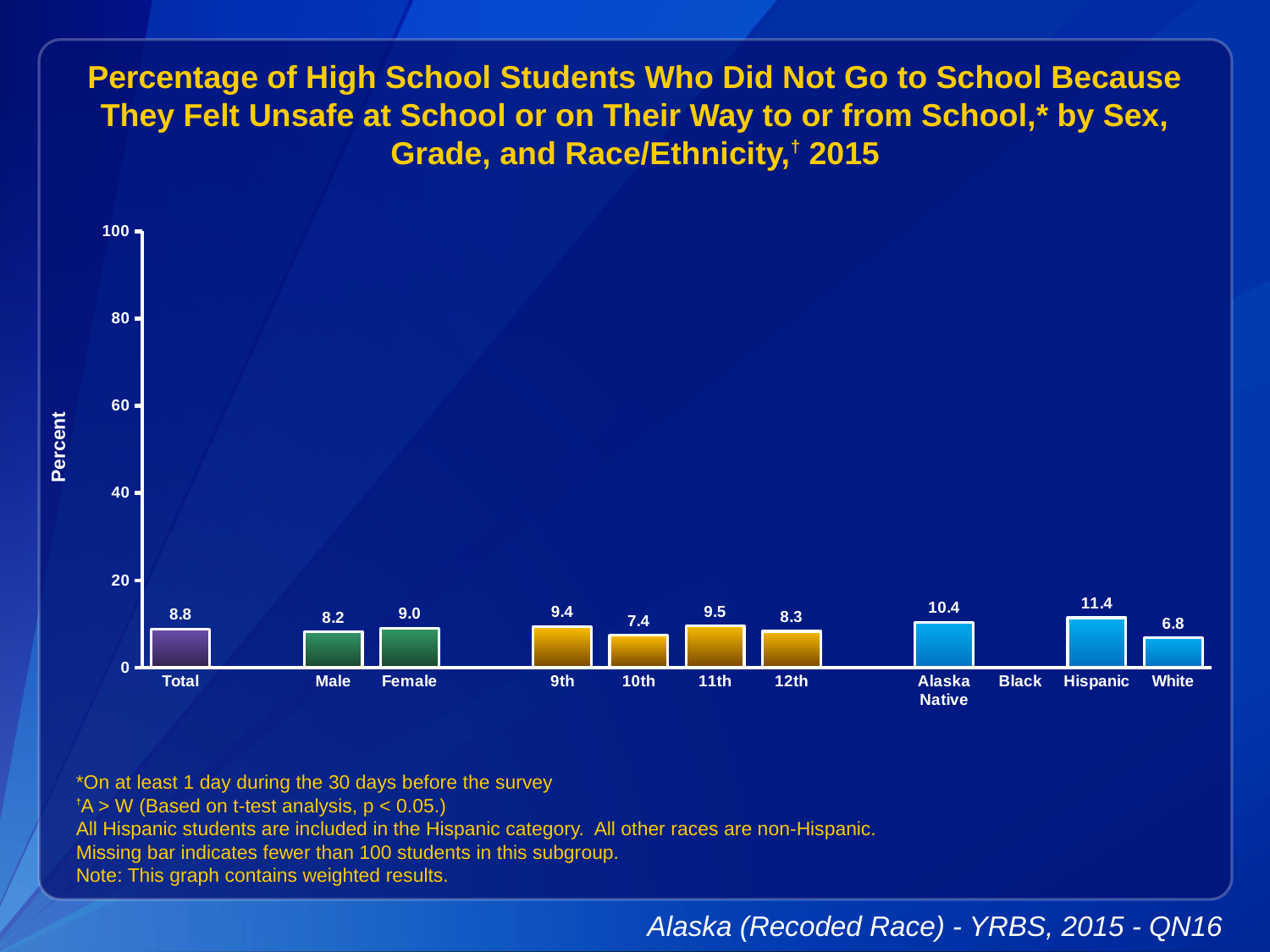
What is the value for Alaska Native? 10.4 Which category has no bar shown? Black Is the value for Hispanic greater or less than 20? less What is the value for Female? 9.0 How many categories have a bar plotted? 11 Which category has the highest value? Hispanic Which category has the lowest value? White What is the value for Total? 8.8 What is the value for 10th grade? 7.4 Which is larger, the value for 11th grade or 12th grade? 11th What is the difference between the values for Female and Male? 0.8 What kind of chart is shown? Bar chart